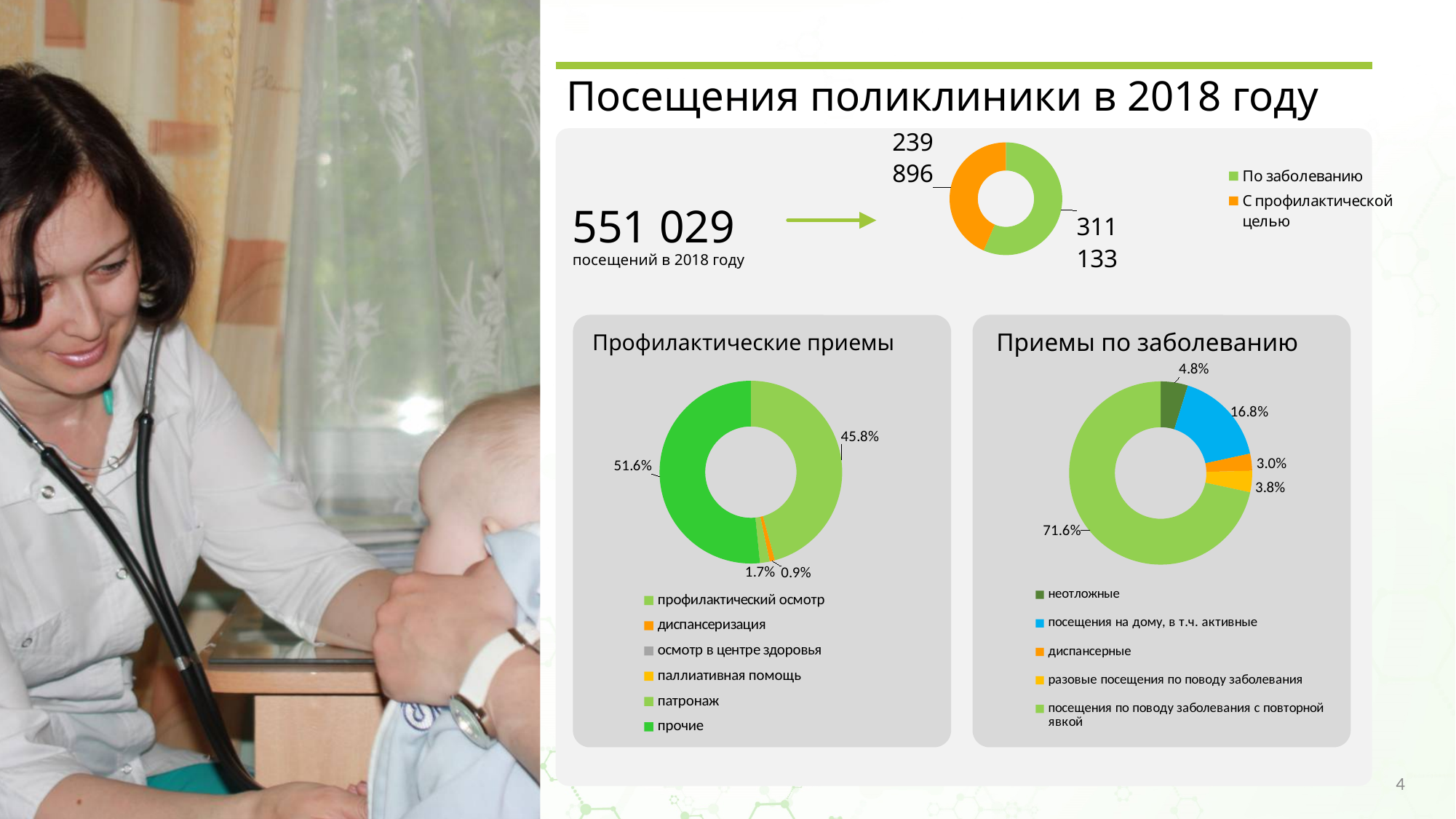
In the top donut chart, what is the value for «С профилактической целью»? 239 896 What type of chart is used in the «Профилактические приемы» panel? Donut (pie) chart In the «Профилактические приемы» chart, what share is labelled for «прочие»? 51.6% In the top donut chart, which category is larger: «По заболеванию» or «С профилактической целью»? По заболеванию In the «Приемы по заболеванию» chart, which category has the largest share? посещения по поводу заболевания с повторной явкой In the «Приемы по заболеванию» chart, which category has the smallest share? диспансерные In the top donut chart, what is the value for «По заболеванию»? 311 133 In the «Профилактические приемы» chart, what share is labelled for «профилактический осмотр»? 45.8% How many entries does the legend of the top donut chart list? 2 In the top donut chart, what is the difference between «По заболеванию» and «С профилактической целью»? 71 237 How many entries does the legend of the «Профилактические приемы» chart list? 6 In the «Приемы по заболеванию» chart, what share is labelled for «посещения на дому, в т.ч. активные»? 16.8%